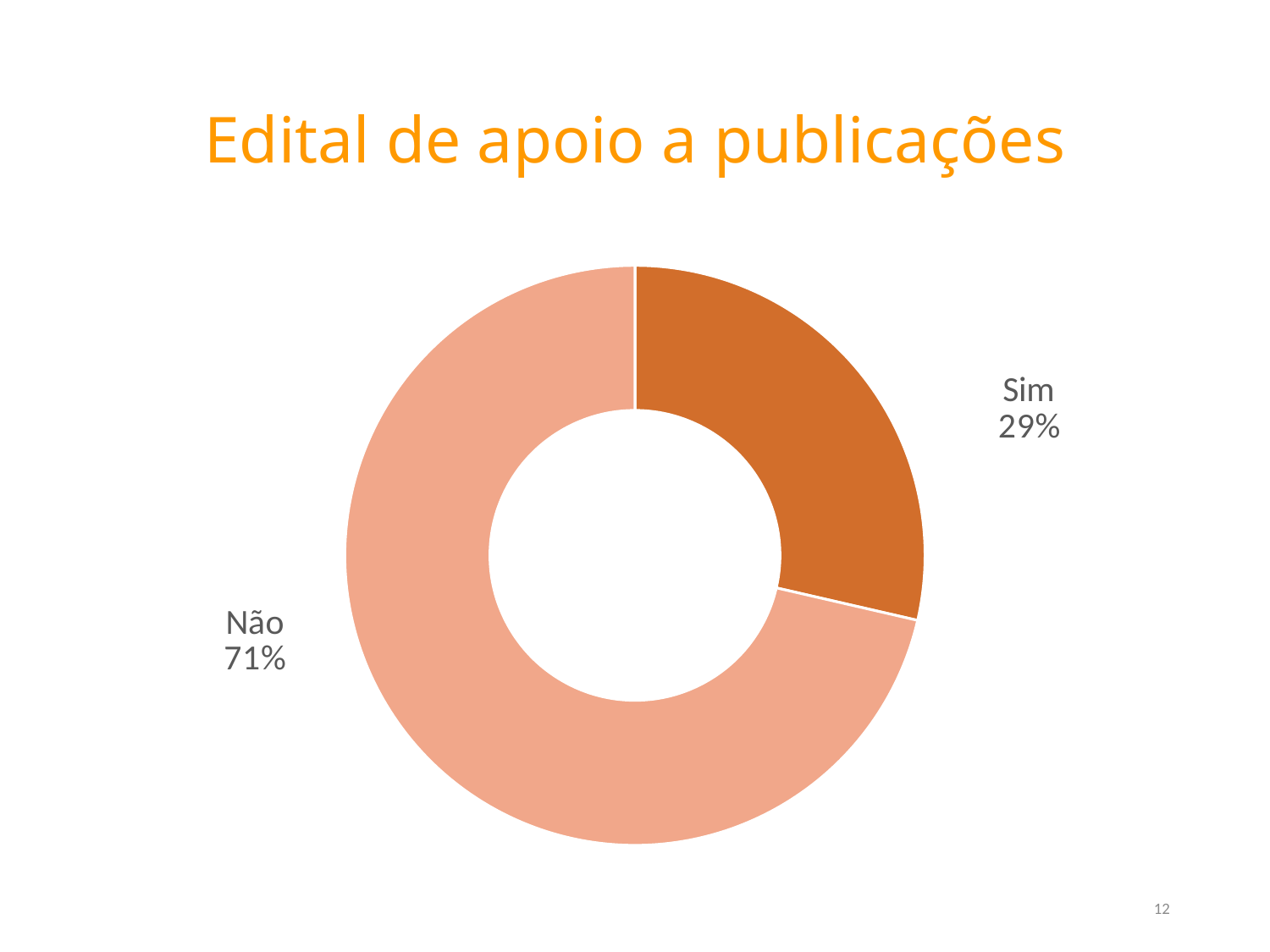
Is the share for "Não" greater or less than 50%? greater Which category has the smallest slice? Sim Which slice is shown in the darker orange colour? Sim What is the title of the slide? Edital de apoio a publicações Which category has the largest slice? Não What is the difference in percentage points between the "Não" and "Sim" slices? 42 What share of the chart does the "Não" slice represent? 71% What kind of chart is shown on the slide? Doughnut (pie) chart What share of the chart does the "Sim" slice represent? 29% What is the total of the two slices' percentages? 100% Which slice is larger, "Sim" or "Não"? Não How many categories are shown in the chart? 2